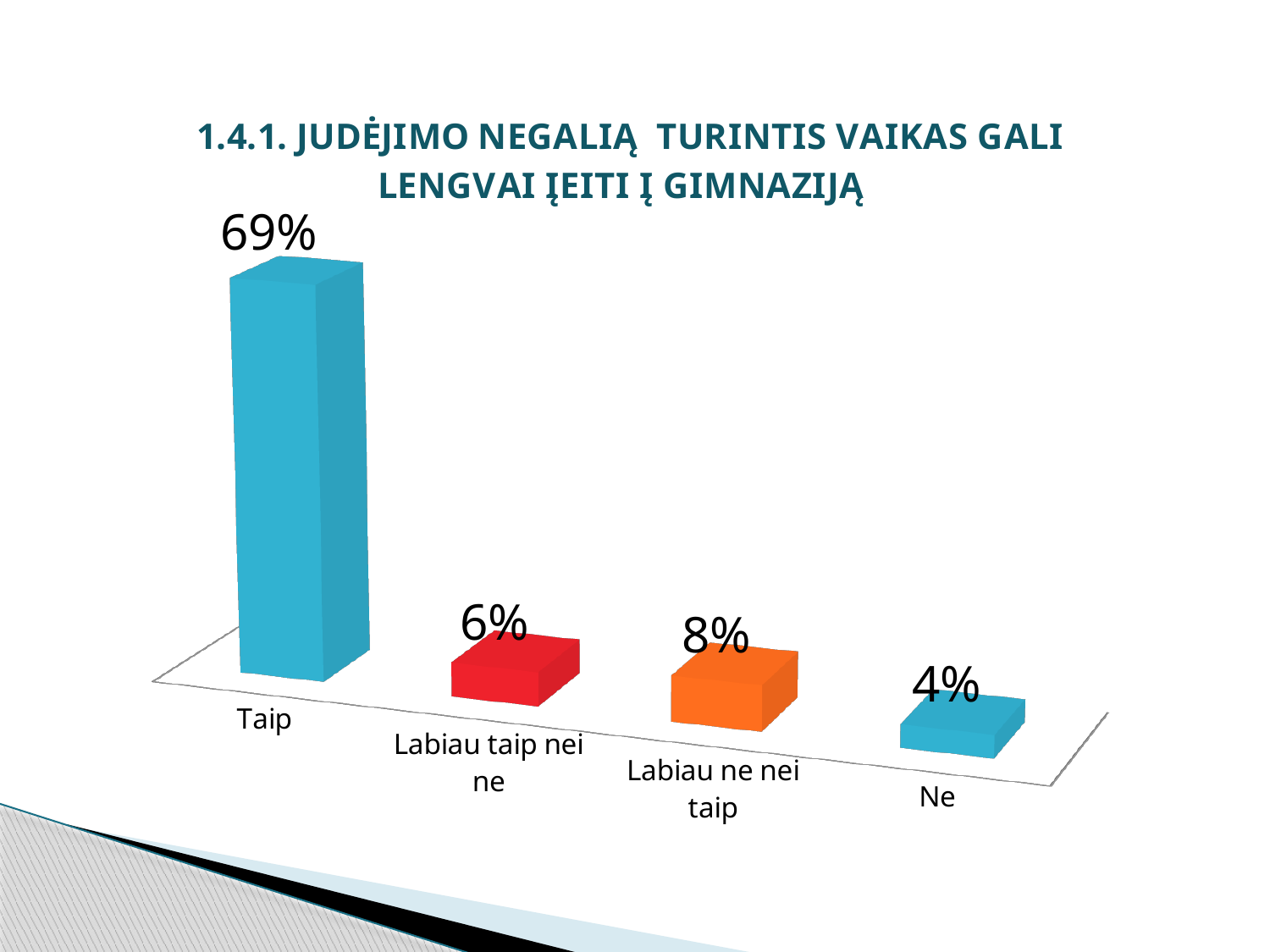
What is the difference between the values for "Labiau ne nei taip" and "Labiau taip nei ne"? 2% What is the value for "Taip"? 69% Which is larger, the value for "Labiau taip nei ne" or the value for "Labiau ne nei taip"? Labiau ne nei taip What is the value for "Labiau ne nei taip"? 8% What is the difference between the values for "Taip" and "Ne"? 65% Which category has the lowest value? Ne What is the value for "Ne"? 4% Which category has the highest value? Taip How many categories are shown in the chart? 4 What kind of chart is shown on the slide? Bar chart What colour is the bar for "Labiau taip nei ne"? Red What is the value for "Labiau taip nei ne"? 6%